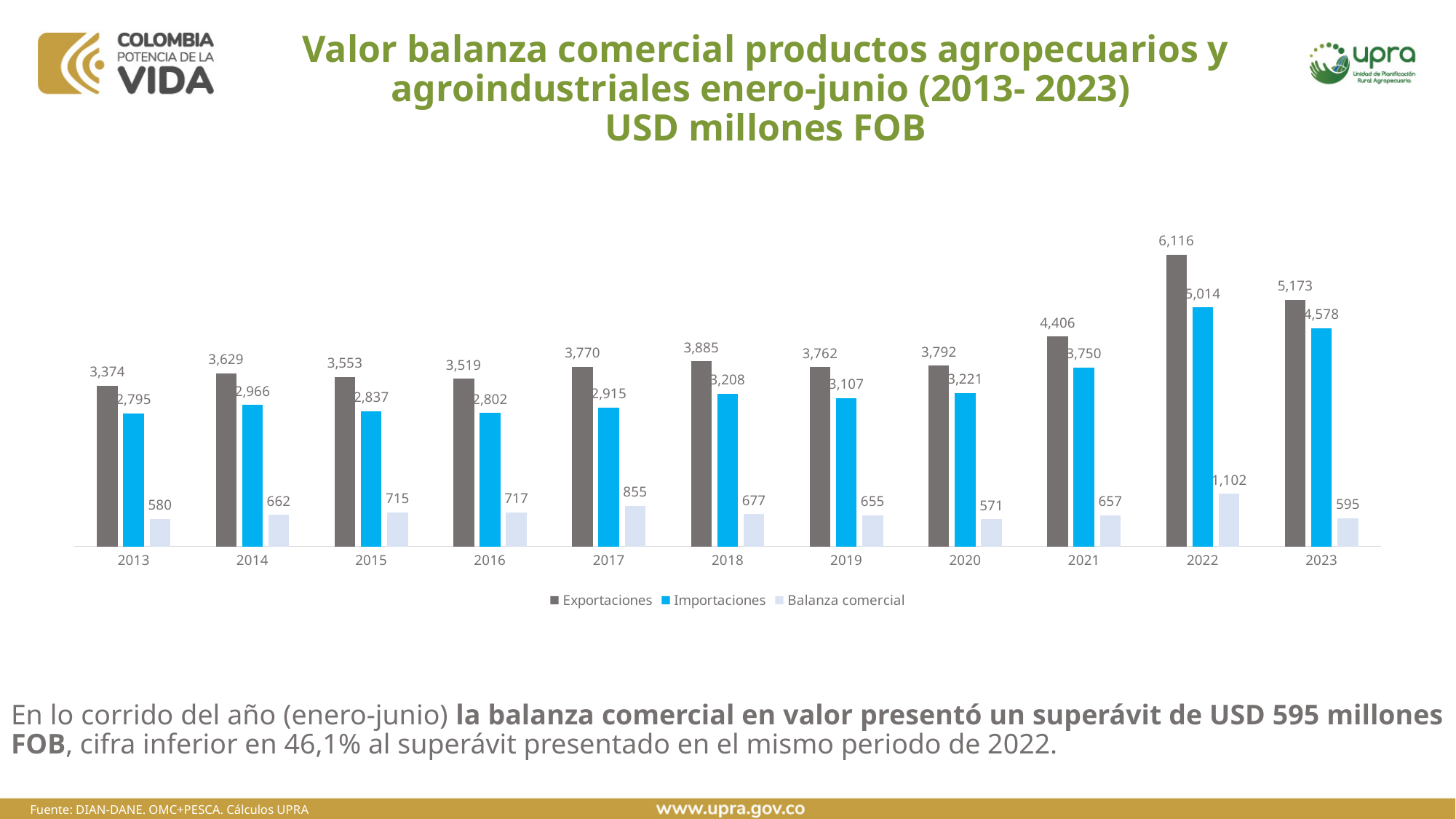
What is the difference between Exportaciones and Importaciones in 2023? 595 What is the value of Exportaciones for 2022? 6,116 Which series is shown in blue in the legend? Importaciones What kind of chart is shown on the slide? Bar chart Which is larger, Importaciones in 2021 or Importaciones in 2020? Importaciones in 2021 Did Exportaciones rise or fall from 2022 to 2023? Fall How many series does the legend list? 3 How many years are shown on the x axis? 11 Which year has the lowest Balanza comercial value? 2020 What is the value of Importaciones for 2019? 3,107 What is the value of Balanza comercial for 2017? 855 Which year has the highest Exportaciones value? 2022